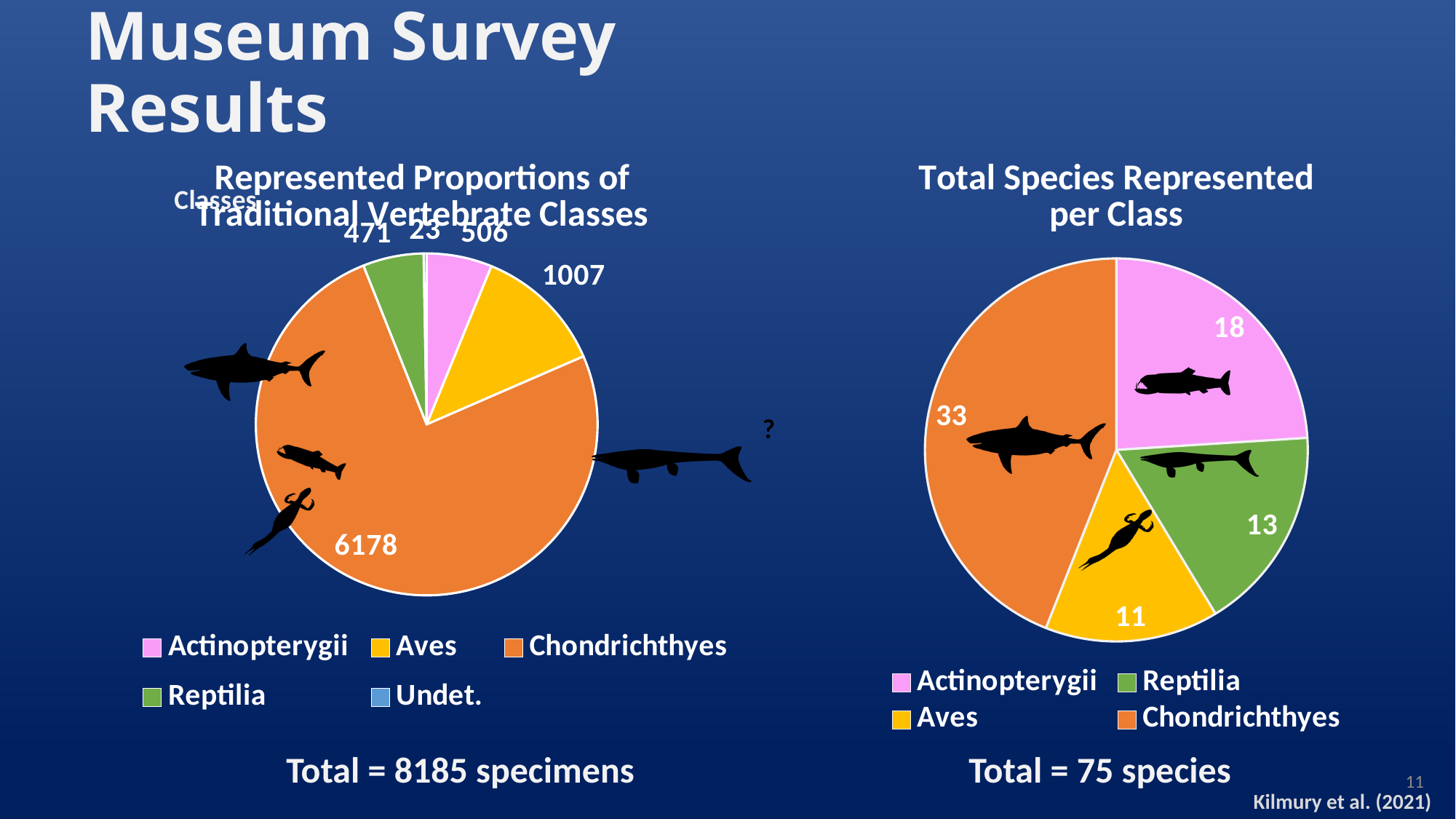
In the left pie chart (Represented Proportions of Traditional Vertebrate Classes), what is the value for Aves? 1007 In the right pie chart (Total Species Represented per Class), how many species are Chondrichthyes? 33 In the right pie chart (Total Species Represented per Class), which class has the fewest species? Aves In the right pie chart (Total Species Represented per Class), what is the value for Reptilia? 13 In the left pie chart (Represented Proportions of Traditional Vertebrate Classes), which category has the smallest slice? Undet. In the left pie chart (Represented Proportions of Traditional Vertebrate Classes), what is the difference between the Aves and Actinopterygii values? 501 What type of chart is used for Total Species Represented per Class? Pie chart In the left pie chart (Represented Proportions of Traditional Vertebrate Classes), which is larger, Aves or Actinopterygii? Aves In the left pie chart (Represented Proportions of Traditional Vertebrate Classes), how many categories does the legend list? 5 In the left pie chart (Represented Proportions of Traditional Vertebrate Classes), which class has the largest slice? Chondrichthyes In the right pie chart (Total Species Represented per Class), what share of the total species is Chondrichthyes? 44% In the left pie chart (Represented Proportions of Traditional Vertebrate Classes), how many specimens are Chondrichthyes? 6178